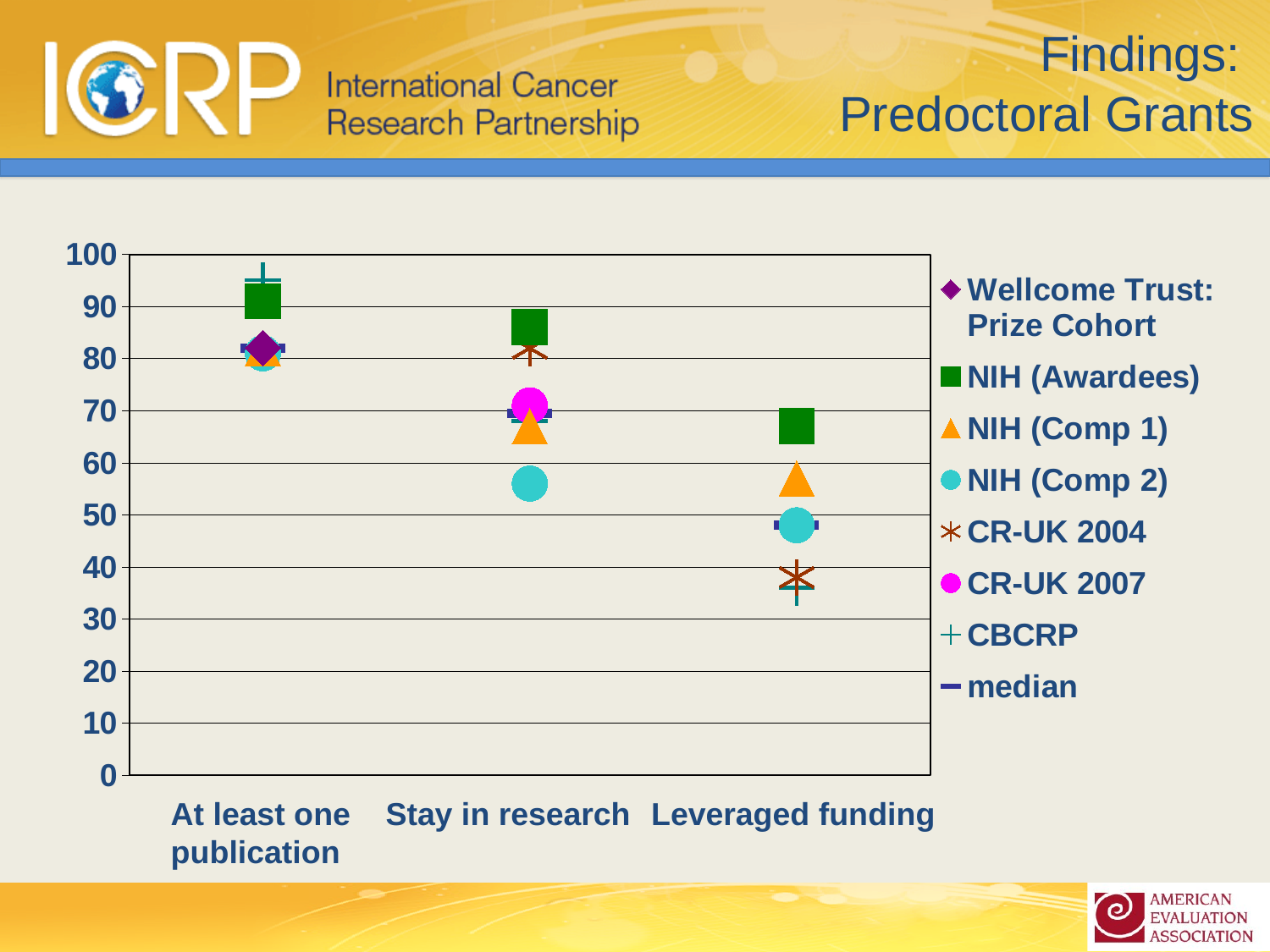
How many series does the legend list? 8 What kind of chart is shown on the slide? scatter chart Do the NIH (Awardees) values rise or fall from At least one publication to Leveraged funding? fall Is the value for CR-UK 2007 at Stay in research greater or less than 60? greater At Stay in research, which is larger: NIH (Awardees) or NIH (Comp 2)? NIH (Awardees) Is the value for NIH (Awardees) at At least one publication greater or less than 80? greater What marker shape and colour does the legend use for NIH (Awardees)? green square Is the value for NIH (Comp 2) at Stay in research greater or less than 60? less How many categories are shown on the x axis? 3 In which category is the NIH (Comp 2) value lowest? Leveraged funding